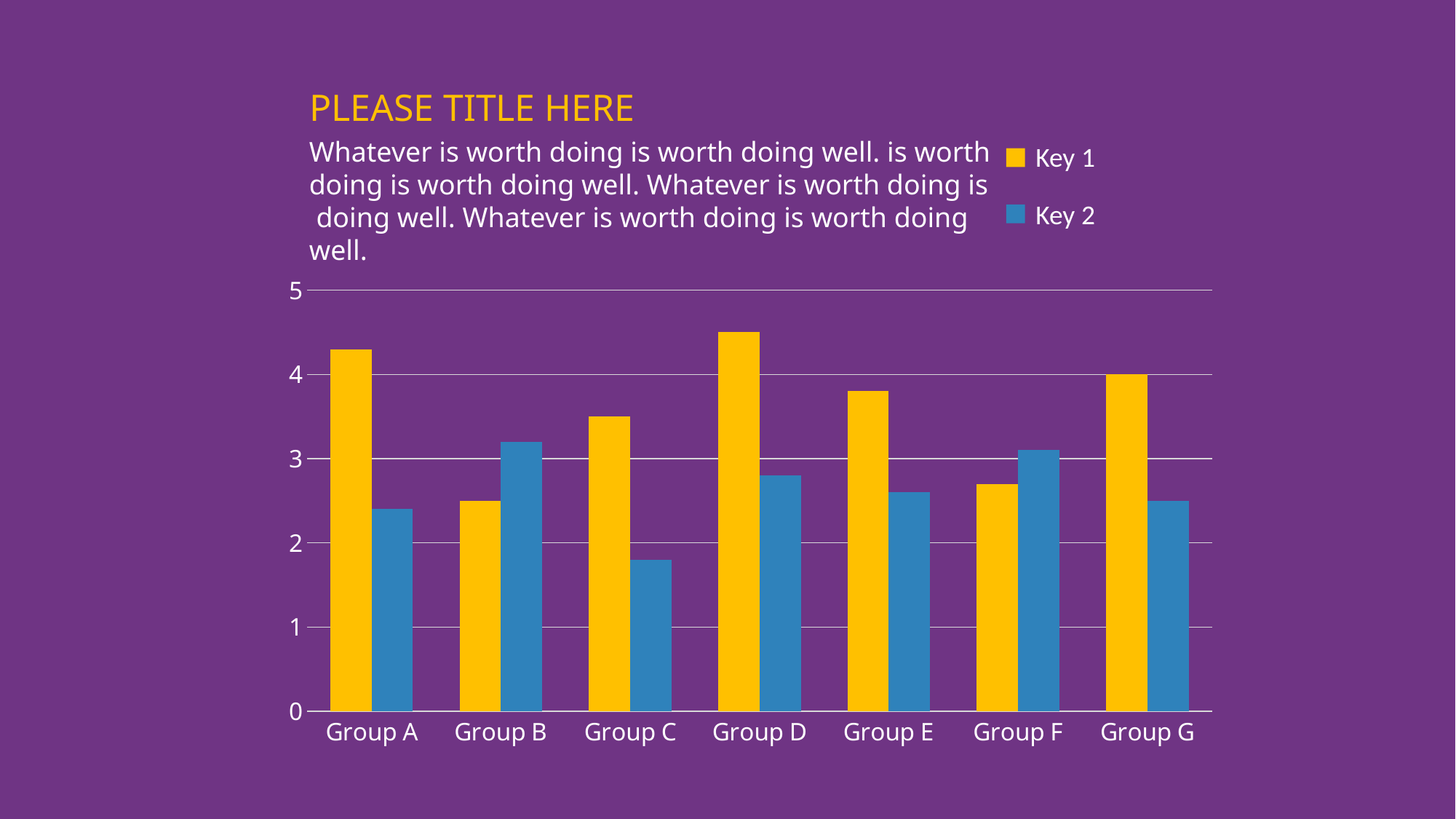
What kind of chart is shown on the slide? bar chart Which group has the highest Key 1 value? Group D Which group has the lowest Key 2 value? Group C How many series does the chart's legend list? 2 Is the Key 1 value for Group A greater or less than 4? greater For Group B, which series has the larger value, Key 1 or Key 2? Key 2 Is the Key 2 value for Group C greater or less than 2? less Is the Key 2 value for Group D greater or less than 3? less How many groups are shown on the x axis of the chart? 7 What colour represents Key 1 in the chart's legend? yellow For Group C, which series has the larger value, Key 1 or Key 2? Key 1